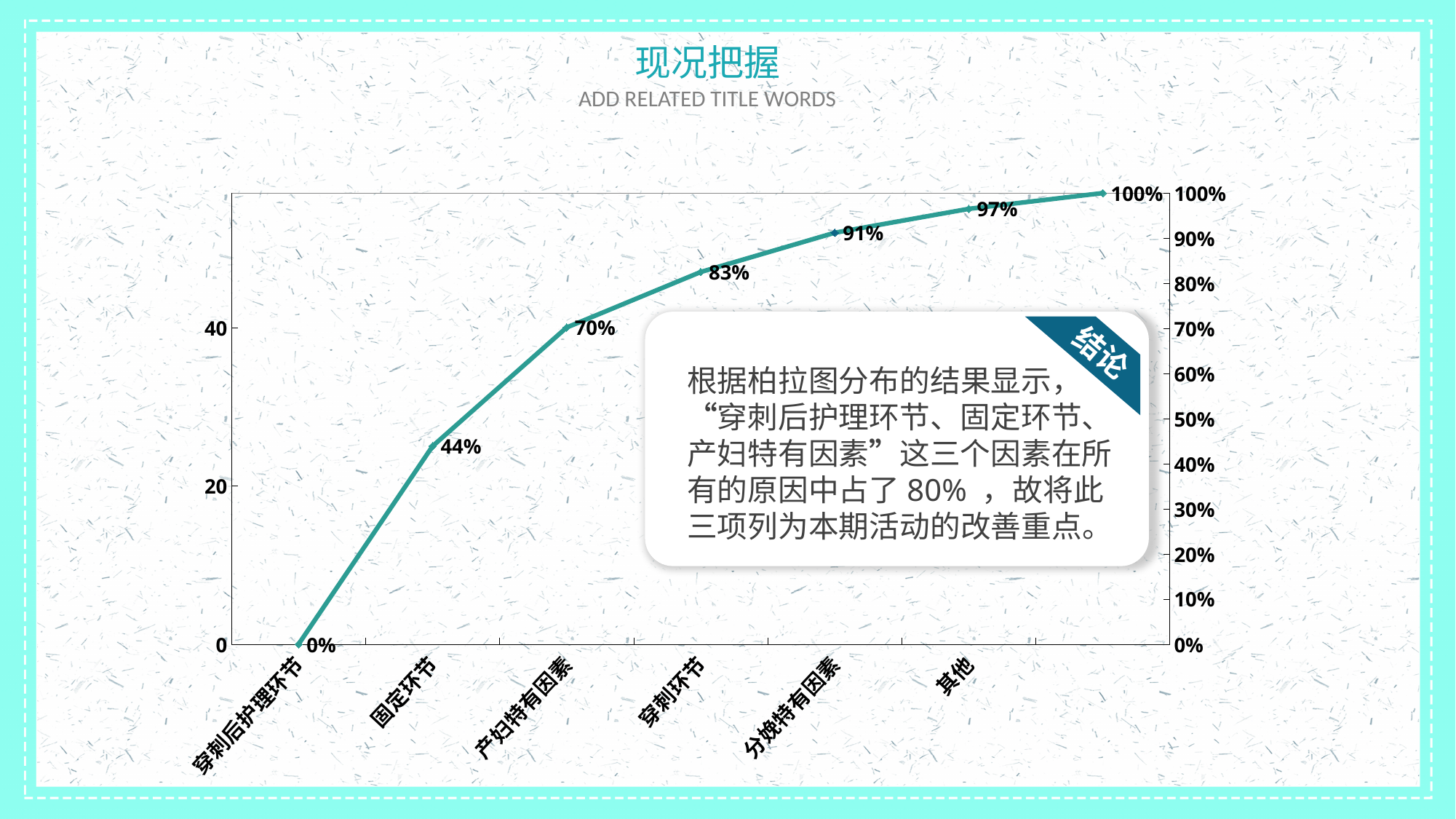
What value is labeled on the point plotted above 分娩特有因素? 91% What value is labeled on the point plotted above 固定环节? 44% What is the highest value labeled on the line? 100% What kind of chart is shown on the slide? line chart How many data points on the line have value labels? 7 What is the title of the slide containing the chart? 现况把握 Do the values on the line rise or fall from left to right along the x axis? rise What is the lowest value labeled on the line? 0% How many categories are labeled on the x axis of the chart? 6 What value is labeled on the point plotted above 穿刺环节? 83% What is the difference between the 70% point and the 44% point on the line? 26% What value is labeled on the point plotted above 产妇特有因素? 70%